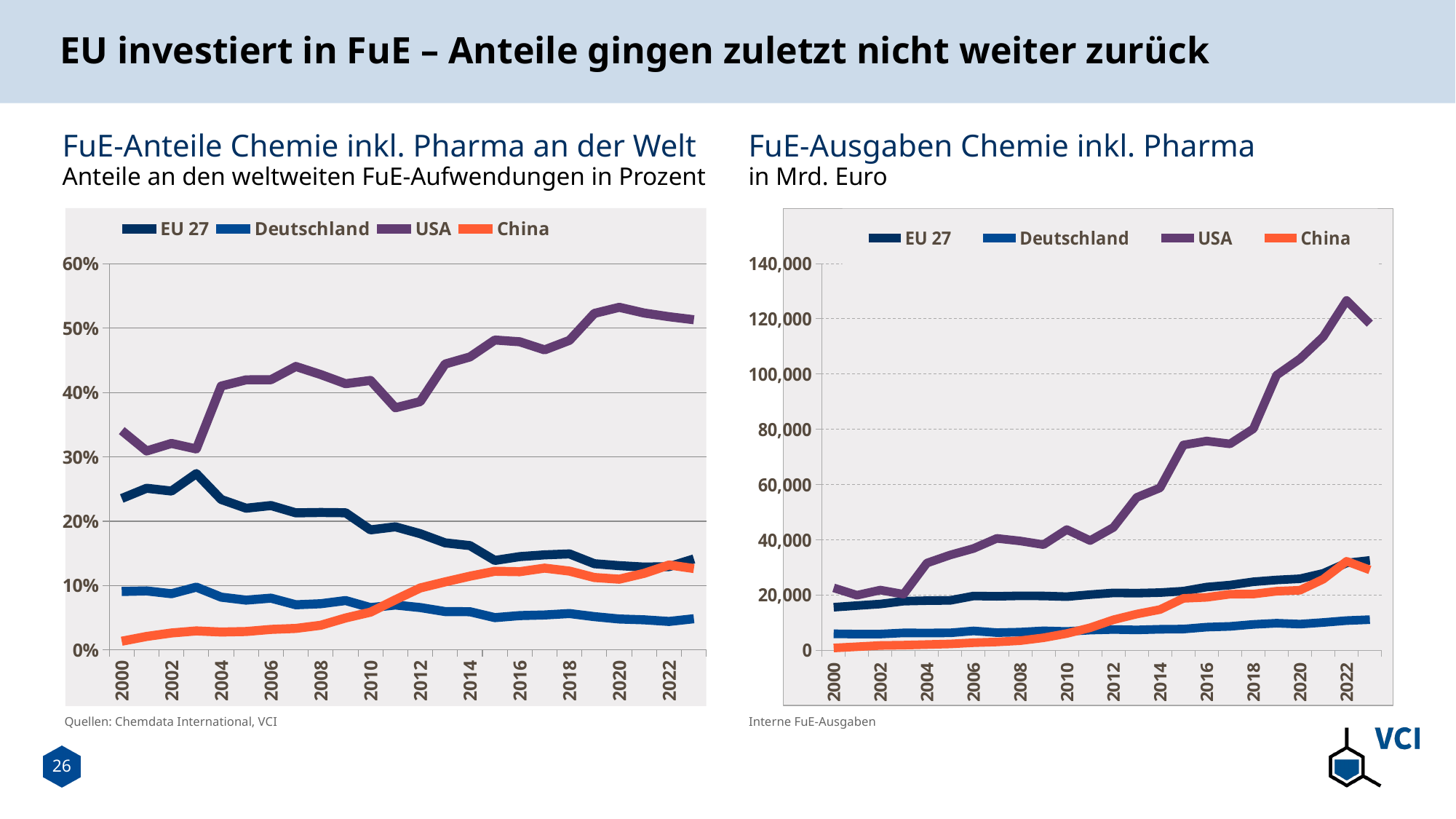
On the right chart (FuE-Ausgaben Chemie inkl. Pharma), what colour is the China line in the legend? Orange On the left chart (FuE-Anteile Chemie inkl. Pharma an der Welt), does the EU 27 share rise or fall from 2000 to 2022? Fall On the left chart (FuE-Anteile Chemie inkl. Pharma an der Welt), is the USA share in 2000 greater or less than 30%? greater On the right chart (FuE-Ausgaben Chemie inkl. Pharma), which is larger in 2022: China or Deutschland? China On the left chart (FuE-Anteile Chemie inkl. Pharma an der Welt), which is larger in 2000: the share of EU 27 or the share of China? EU 27 On the right chart (FuE-Ausgaben Chemie inkl. Pharma), is the Deutschland value in 2022 greater or less than 20,000? less On the right chart (FuE-Ausgaben Chemie inkl. Pharma), which series has the lowest value in 2000? China On the left chart (FuE-Anteile Chemie inkl. Pharma an der Welt), does the China share rise or fall from 2000 to 2022? Rise What kind of chart is the right chart (FuE-Ausgaben Chemie inkl. Pharma)? Line chart On the left chart (FuE-Anteile Chemie inkl. Pharma an der Welt), which series has the highest share in 2022? USA On the left chart (FuE-Anteile Chemie inkl. Pharma an der Welt), how many series does the legend list? 4 On the right chart (FuE-Ausgaben Chemie inkl. Pharma), is the USA value in 2022 greater or less than 120,000? greater